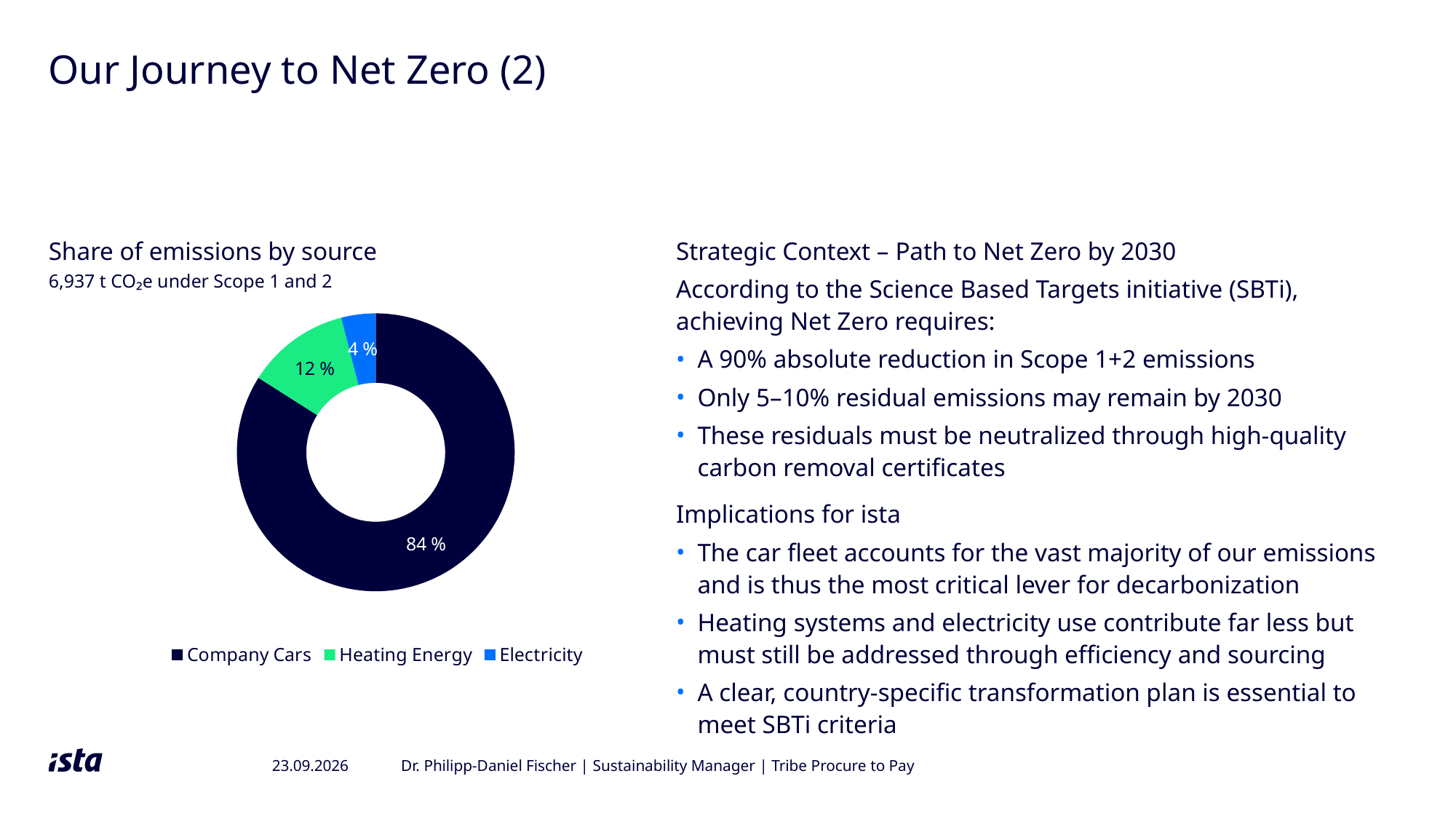
Which emission source has the largest share? Company Cars What is the difference in percentage points between the Heating Energy share and the Electricity share? 8 How many emission sources are shown in the chart? 3 What is the difference in percentage points between the Company Cars share and the Heating Energy share? 72 What is the title of the chart? Share of emissions by source What share of emissions comes from Company Cars? 84 % What total amount of emissions under Scope 1 and 2 does the chart subtitle state? 6,937 t CO₂e Which has a larger share, Heating Energy or Electricity? Heating Energy What share of emissions comes from Electricity? 4 % What kind of chart is used to show the share of emissions by source? Doughnut (pie) chart Which emission source has the smallest share? Electricity What share of emissions comes from Heating Energy? 12 %